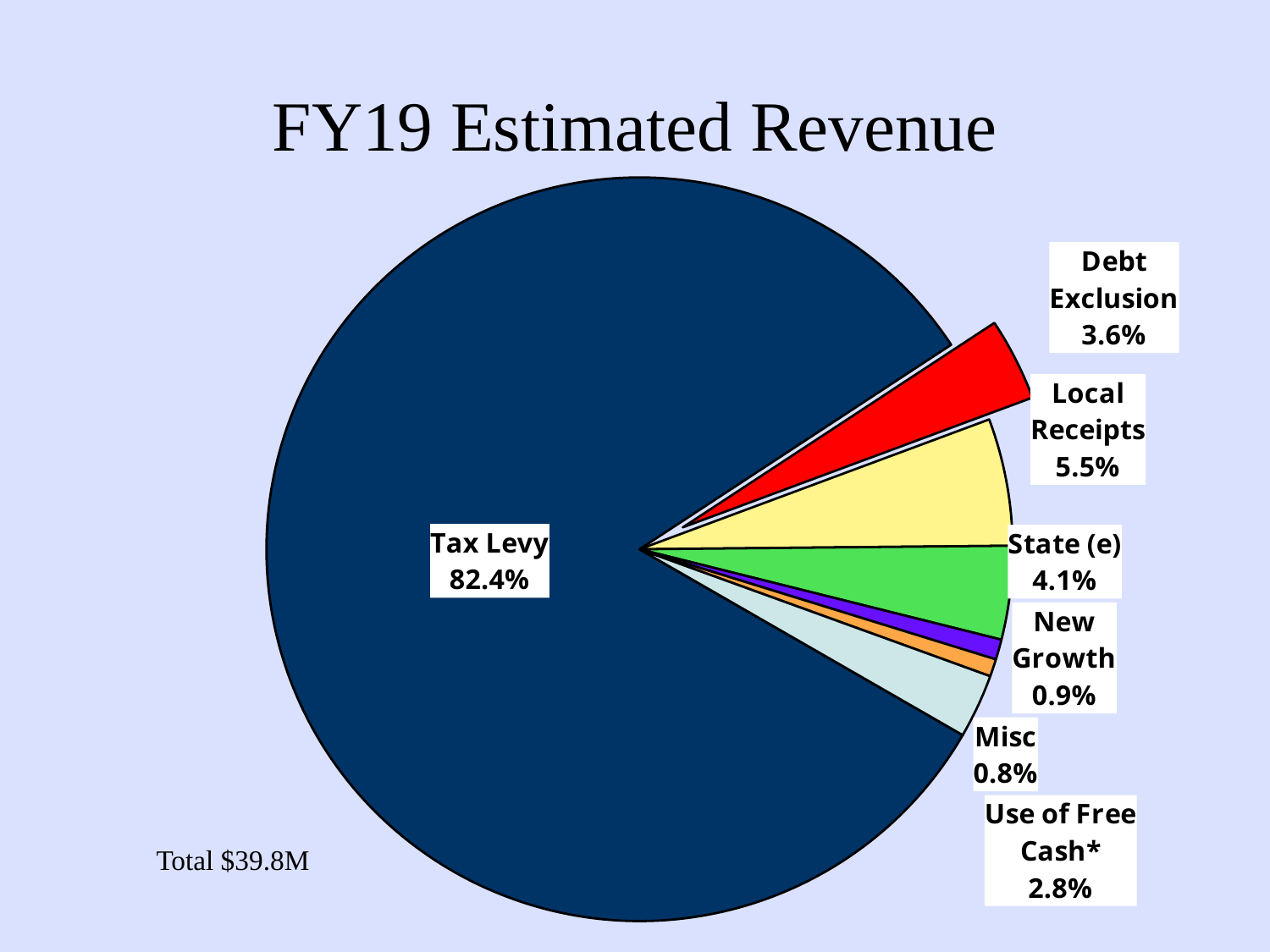
Which category has the smallest slice of the pie? Misc What share of FY19 Estimated Revenue is the Tax Levy? 82.4% What is the difference between the Local Receipts share and the State (e) share? 1.4% What percentage is shown for State (e)? 4.1% What kind of chart is shown on the slide? Pie chart Which is larger, Debt Exclusion or Use of Free Cash*? Debt Exclusion What total revenue amount is stated on the slide? $39.8M How many categories are shown in the pie chart? 7 What is the value shown for Debt Exclusion? 3.6% What percentage of the pie is Local Receipts? 5.5% Which category has the largest slice of the pie? Tax Levy What is the value for Use of Free Cash*? 2.8%